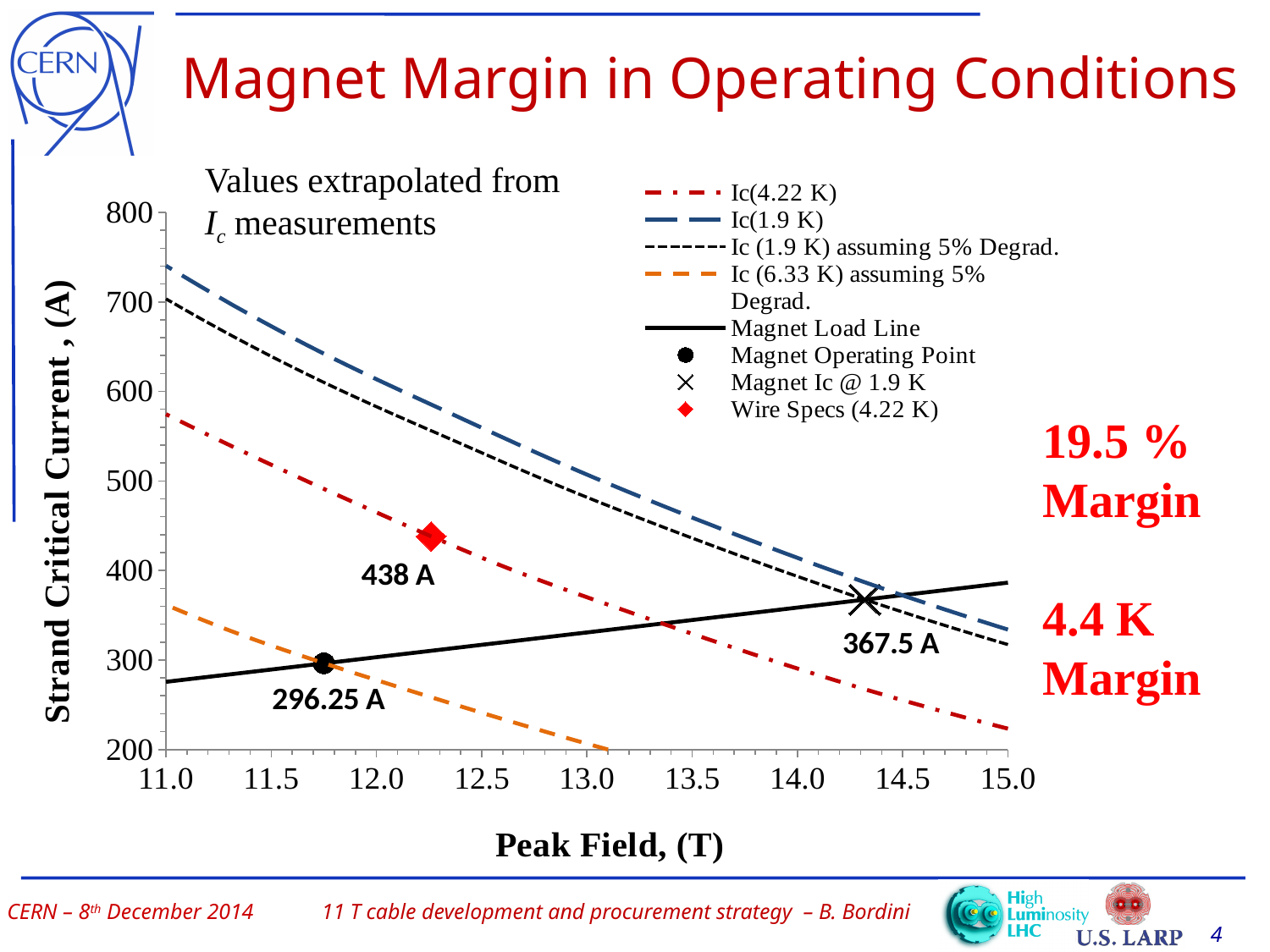
What kind of chart is shown on the slide? Line chart What is the difference between the Magnet Ic @ 1.9 K value and the Magnet Operating Point value? 71.25 A Does the Ic(1.9 K) curve rise or fall as Peak Field increases? Falls Which of the three labelled points has the highest value? Wire Specs (4.22 K) Does the Magnet Load Line rise or fall as Peak Field increases? Rises What is the difference between the Wire Specs (4.22 K) value and the Magnet Operating Point value? 141.75 A How many entries does the legend list? 8 What is the labelled value of the Magnet Operating Point? 296.25 A What is the labelled value of the Magnet Ic @ 1.9 K point? 367.5 A What is the labelled value of the Wire Specs (4.22 K) point? 438 A Which labelled point has the larger value, Wire Specs (4.22 K) or Magnet Ic @ 1.9 K? Wire Specs (4.22 K) Is the Ic(1.9 K) value at 11.0 T greater or less than 700? greater